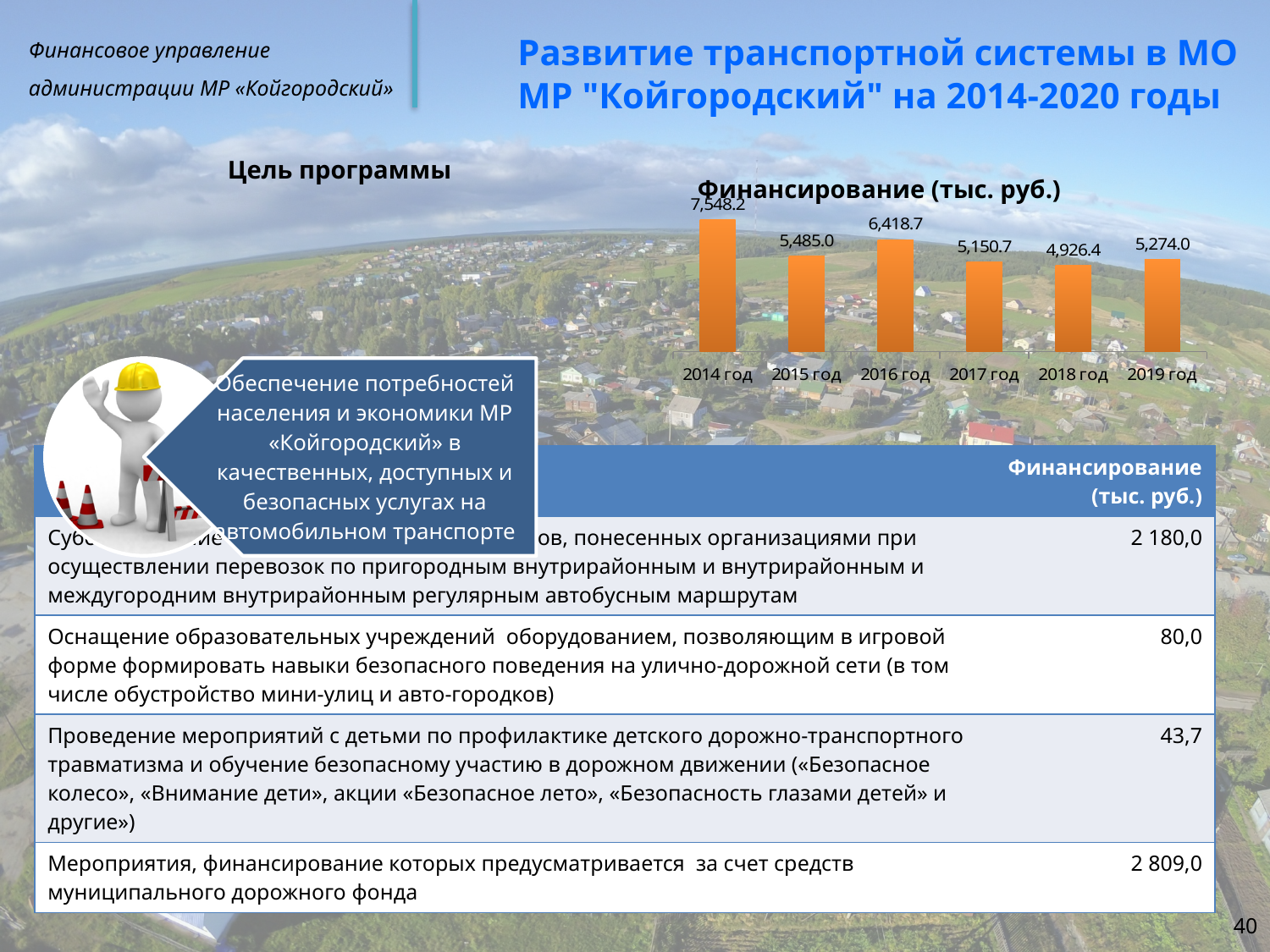
Which year has the highest value in the Финансирование (тыс. руб.) chart? 2014 год Does the value in the Финансирование (тыс. руб.) chart rise or fall from 2014 год to 2015 год? fall What is the difference between the values for 2014 год and 2015 год in the Финансирование (тыс. руб.) chart? 2,063.2 Which is larger in the Финансирование (тыс. руб.) chart: the value for 2017 год or 2019 год? 2019 год What kind of chart is the Финансирование (тыс. руб.) chart? bar chart What is the value for 2018 год in the Финансирование (тыс. руб.) chart? 4,926.4 What is the title of the chart on the slide? Финансирование (тыс. руб.) How many years are shown in the Финансирование (тыс. руб.) chart? 6 What is the value for 2016 год in the Финансирование (тыс. руб.) chart? 6,418.7 What is the value for 2019 год in the Финансирование (тыс. руб.) chart? 5,274.0 Which year has the lowest value in the Финансирование (тыс. руб.) chart? 2018 год What is the value for 2014 год in the Финансирование (тыс. руб.) chart? 7,548.2